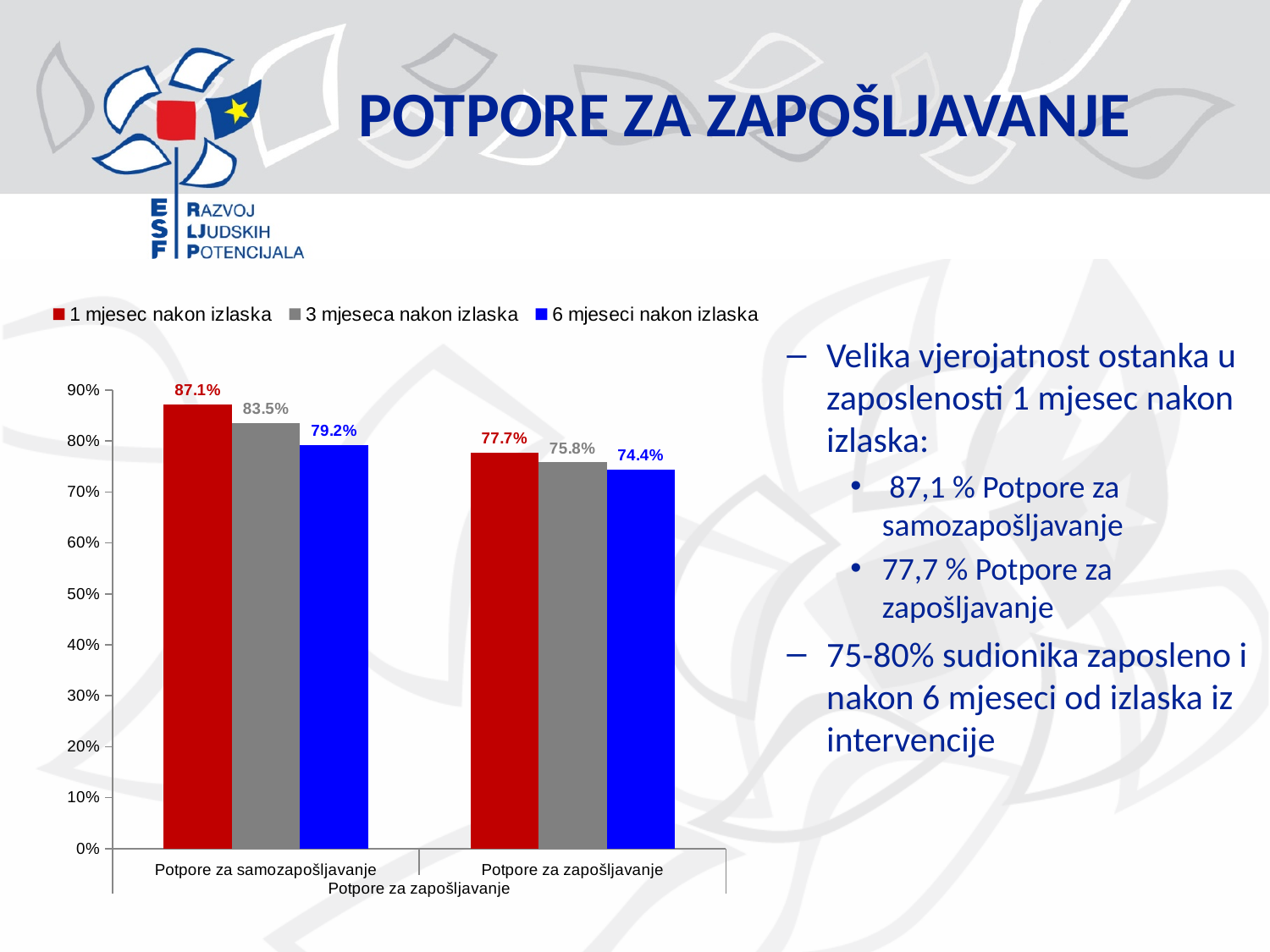
Which is larger: the '6 mjeseci nakon izlaska' value for 'Potpore za samozapošljavanje' or the '3 mjeseca nakon izlaska' value for 'Potpore za zapošljavanje'? 6 mjeseci nakon izlaska for Potpore za samozapošljavanje Which colour represents the '3 mjeseca nakon izlaska' series? Grey What is the value for '3 mjeseca nakon izlaska' in the 'Potpore za samozapošljavanje' category? 83.5% Which series has the lowest value in the 'Potpore za zapošljavanje' category? 6 mjeseci nakon izlaska What kind of chart is shown on the slide? Bar chart What is the difference between the '1 mjesec nakon izlaska' and '6 mjeseci nakon izlaska' values for 'Potpore za samozapošljavanje'? 7.9% How many categories are shown on the x axis? 2 How many series does the legend list? 3 What is the value for '1 mjesec nakon izlaska' in the 'Potpore za samozapošljavanje' category? 87.1% What is the difference between the '1 mjesec nakon izlaska' values for 'Potpore za samozapošljavanje' and 'Potpore za zapošljavanje'? 9.4% What is the value for '6 mjeseci nakon izlaska' in the 'Potpore za zapošljavanje' category? 74.4% Which category has the highest value for '1 mjesec nakon izlaska'? Potpore za samozapošljavanje